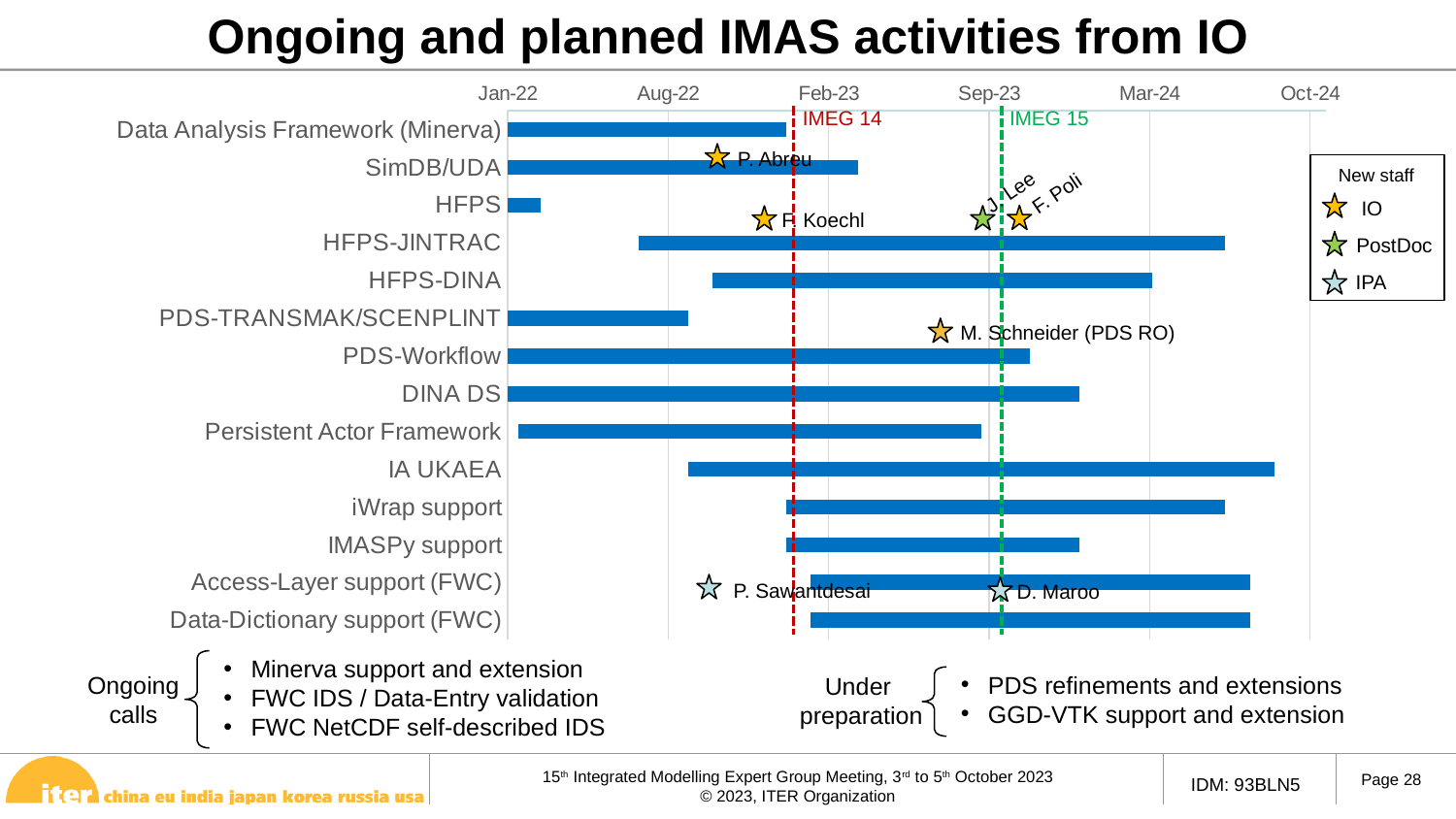
Which activity has the shortest bar on the chart? HFPS How many activities (rows) are listed on the chart? 14 What kind of chart is shown on the slide? Gantt chart (horizontal bar chart) Does the Data Analysis Framework (Minerva) bar end before or after Feb-23? before Which bar starts earlier, IA UKAEA or iWrap support? IA UKAEA What is the first date tick shown on the time axis? Jan-22 How many entries does the 'New staff' legend list? 3 Which bar ends later, HFPS-JINTRAC or HFPS-DINA? HFPS-JINTRAC Which activity's bar extends furthest to the right on the timeline? IA UKAEA What are the labels of the two vertical dashed lines on the chart? IMEG 14 and IMEG 15 Does the HFPS bar end before or after Aug-22? before